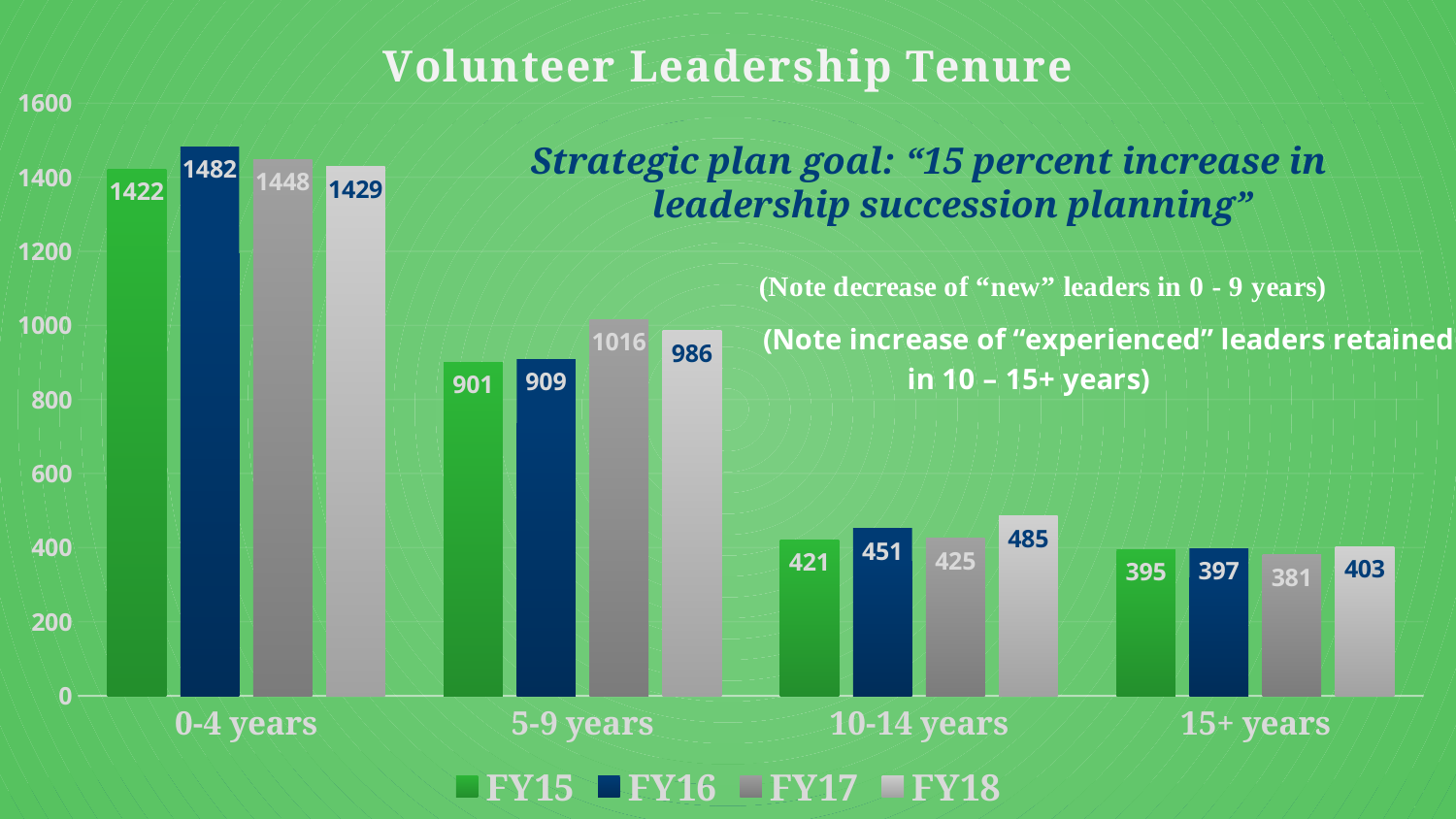
Which tenure category has the highest FY15 value? 0-4 years What is the FY17 value for the 15+ years category? 381 What is the difference between the FY17 and FY15 values for the 5-9 years category? 115 Which tenure category has the lowest FY18 value? 15+ years How many tenure categories are shown on the x axis? 4 What is the title of the chart? Volunteer Leadership Tenure What is the FY18 value for the 10-14 years category? 485 What kind of chart is shown on the slide? bar chart Which is larger for the 10-14 years category, the FY16 value or the FY17 value? FY16 What is the FY16 value for the 0-4 years category? 1482 Is the FY18 value for the 5-9 years category greater or less than 1000? less How many series does the legend list? 4